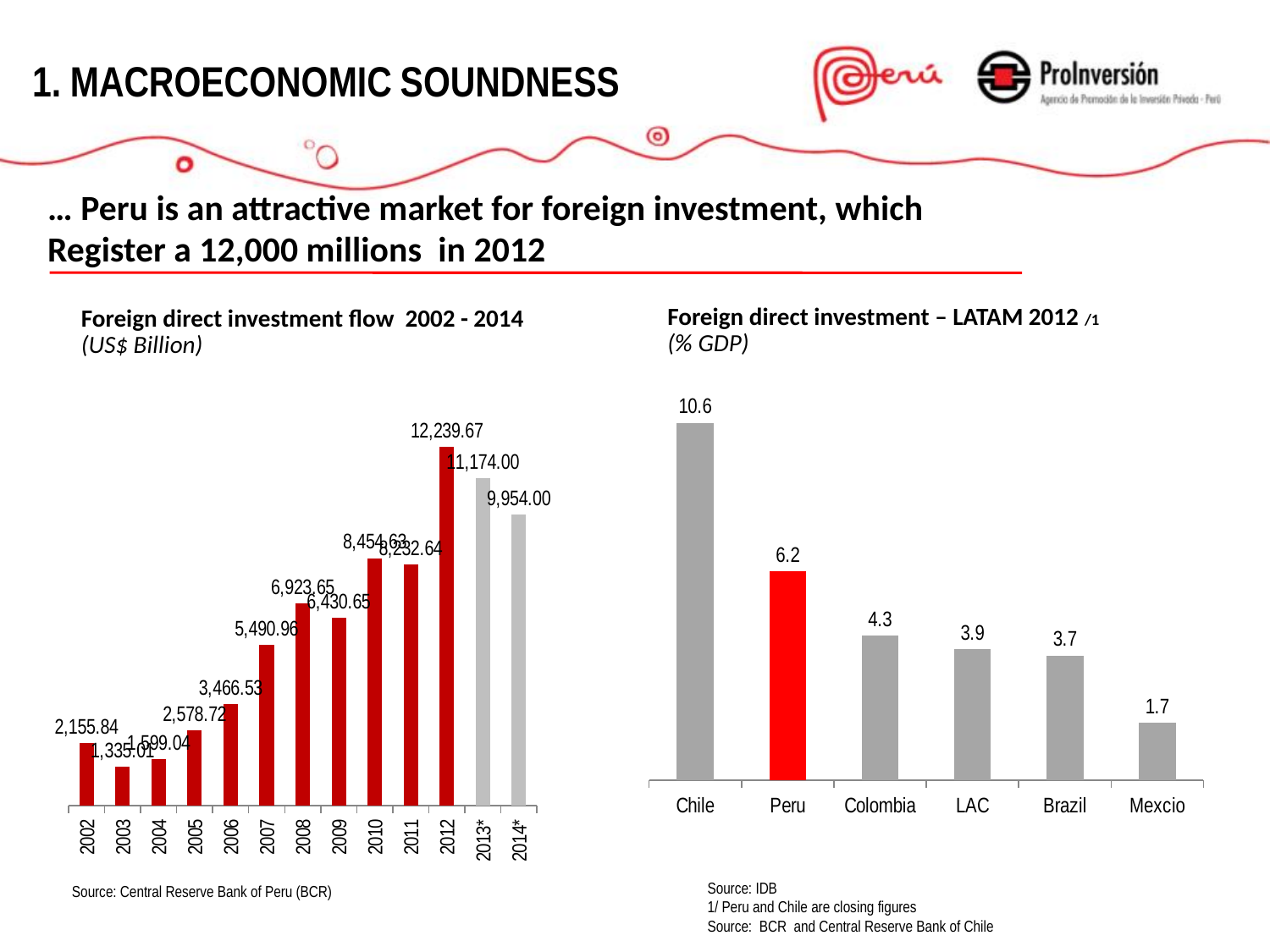
In the Foreign direct investment flow 2002 - 2014 chart, which year has the highest value? 2012 In the Foreign direct investment flow 2002 - 2014 chart, what is the value for 2007? 5,490.96 In the Foreign direct investment flow 2002 - 2014 chart, which year has the lowest value? 2003 In the Foreign direct investment – LATAM 2012 chart, what is the value for Peru? 6.2 In the Foreign direct investment flow 2002 - 2014 chart, what is the difference between the 2012 value and the 2013* value? 1,065.67 In the Foreign direct investment flow 2002 - 2014 chart, what is the value for 2012? 12,239.67 In the Foreign direct investment flow 2002 - 2014 chart, do the values rise or fall from 2012 to 2014*? fall In the Foreign direct investment – LATAM 2012 chart, which country has the highest value? Chile In the Foreign direct investment flow 2002 - 2014 chart, what is the value for 2014*? 9,954.00 In the Foreign direct investment – LATAM 2012 chart, what is the difference between Chile and Peru? 4.4 In the Foreign direct investment – LATAM 2012 chart, which bar is coloured red? Peru In the Foreign direct investment flow 2002 - 2014 chart, how many years are plotted? 13